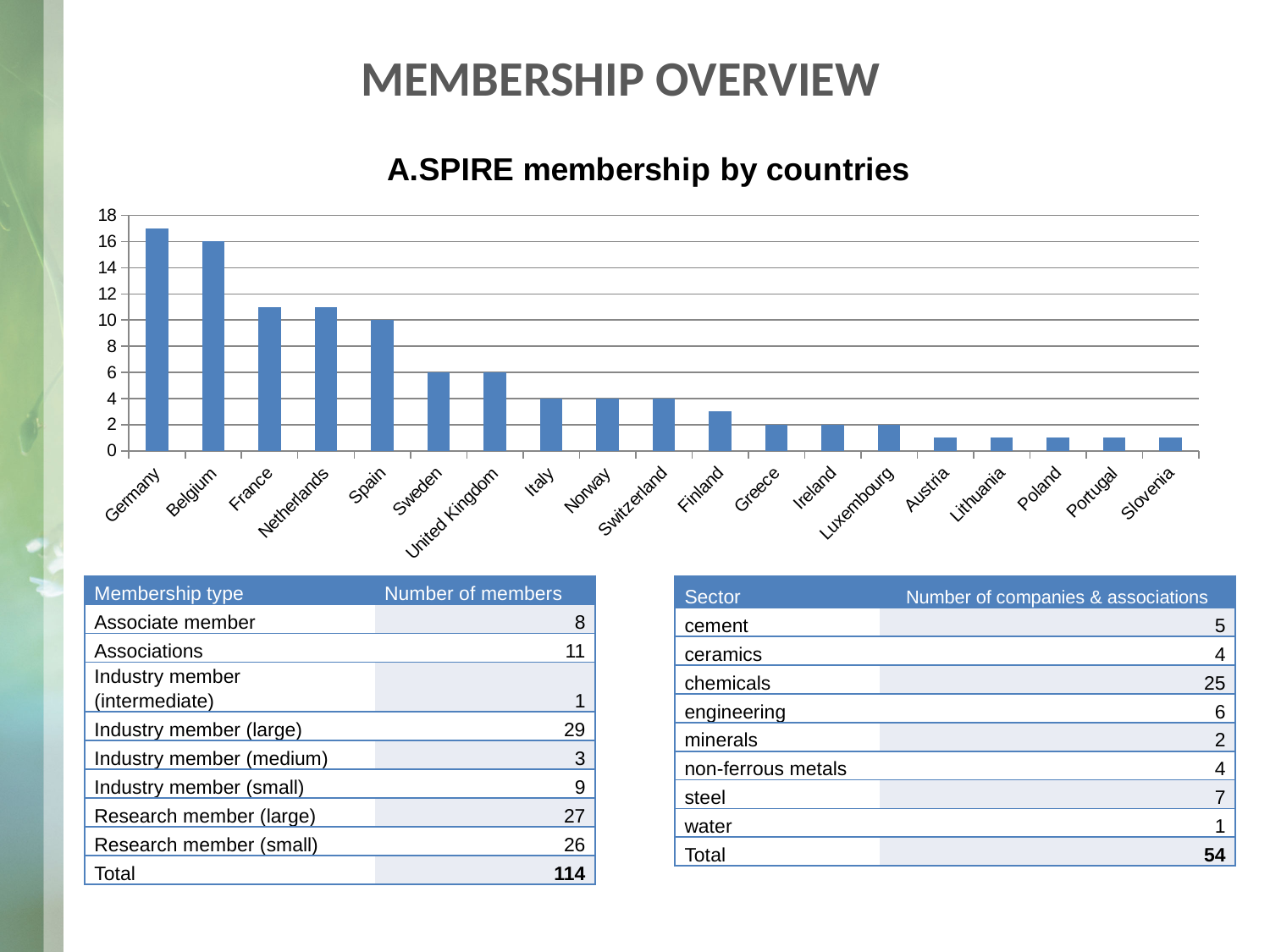
Is the value for Germany greater or less than 16? greater How many countries are shown in the A.SPIRE membership by countries chart? 19 What is the value for Belgium in the A.SPIRE membership by countries chart? 16 Is the value for France greater or less than 10? greater What kind of chart is shown on the slide? bar chart What is the value for Spain in the A.SPIRE membership by countries chart? 10 Which country has the highest number of A.SPIRE members in the chart? Germany Is the value for Finland greater or less than 4? less Do the values rise or fall from left to right across the countries on the x axis? fall What is the difference between the values for Belgium and Spain? 6 What is the value for Sweden in the A.SPIRE membership by countries chart? 6 What is the value for Italy in the A.SPIRE membership by countries chart? 4